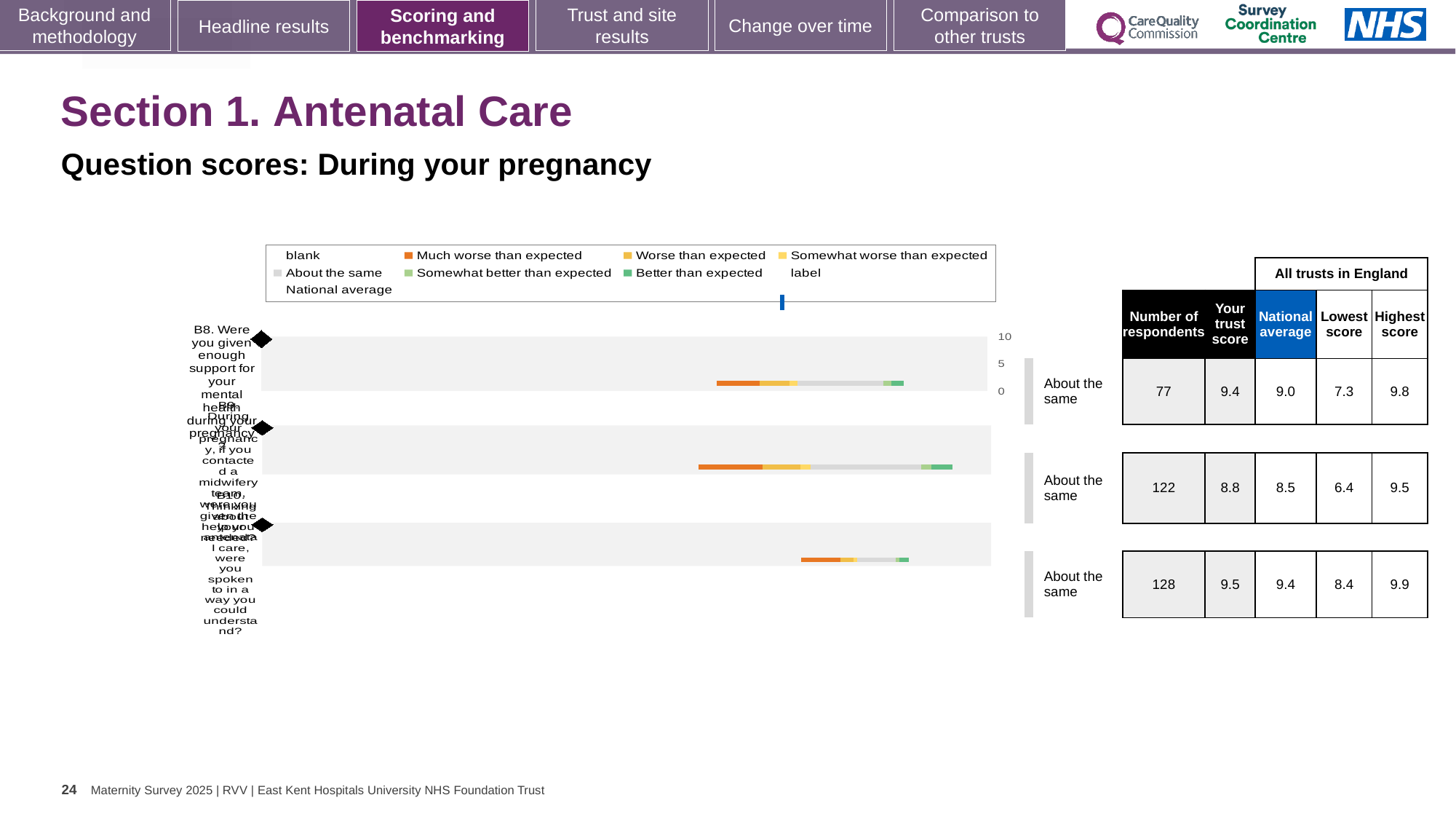
For the second question row, how much higher is the trust score than the national average? 0.3 What is the trust score for the first question (B8) in the table? 9.4 What is the highest score across all trusts in England for the third question row? 9.9 For the third question row, which is larger: the trust score or the national average? The trust score (9.5) What benchmark category is shown next to each of the three question rows? About the same Which question row has the largest number of respondents? The third row (128) What type of chart is used to show the question scores? Bar chart Which question row has the lowest 'Lowest score' value? The second row (6.4) What is the national average for the second question row in the table? 8.5 How many questions are plotted in the chart? 3 How many respondents are shown for the first question (B8, support for your mental health during pregnancy)? 77 For the first question (B8), what is the difference between the highest score and the lowest score? 2.5